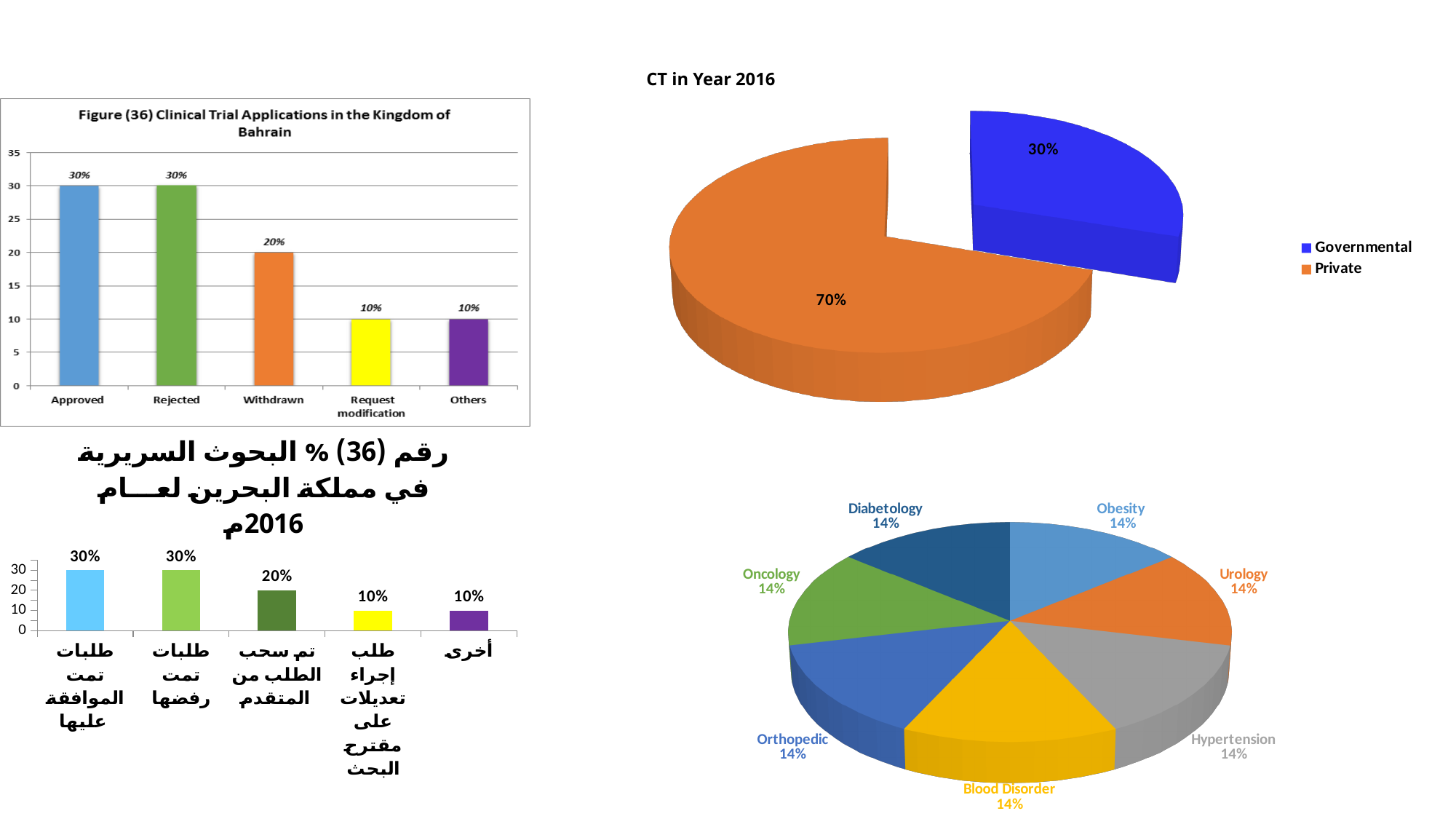
In the chart titled "Figure (36) Clinical Trial Applications in the Kingdom of Bahrain", how many categories are shown on the x axis? 5 What kind of chart is the one titled "Figure (36) Clinical Trial Applications in the Kingdom of Bahrain"? Bar chart In the pie chart titled "CT in Year 2016", what share is Governmental? 30% In the chart titled "Figure (36) Clinical Trial Applications in the Kingdom of Bahrain", what is the value for Withdrawn? 20% In the pie chart titled "CT in Year 2016", which slice is the largest? Private In the pie chart at the bottom right of the slide, how many slices are there? 7 In the chart titled "Figure (36) Clinical Trial Applications in the Kingdom of Bahrain", which is larger, Rejected or Withdrawn? Rejected In the pie chart titled "CT in Year 2016", what share is Private? 70% In the pie chart titled "CT in Year 2016", how many entries does the legend list? 2 In the pie chart at the bottom right of the slide, what share is Blood Disorder? 14% In the chart titled "Figure (36) Clinical Trial Applications in the Kingdom of Bahrain", what is the difference between the Approved value and the Others value? 20% In the chart titled "Figure (36) Clinical Trial Applications in the Kingdom of Bahrain", what is the value for Request modification? 10%